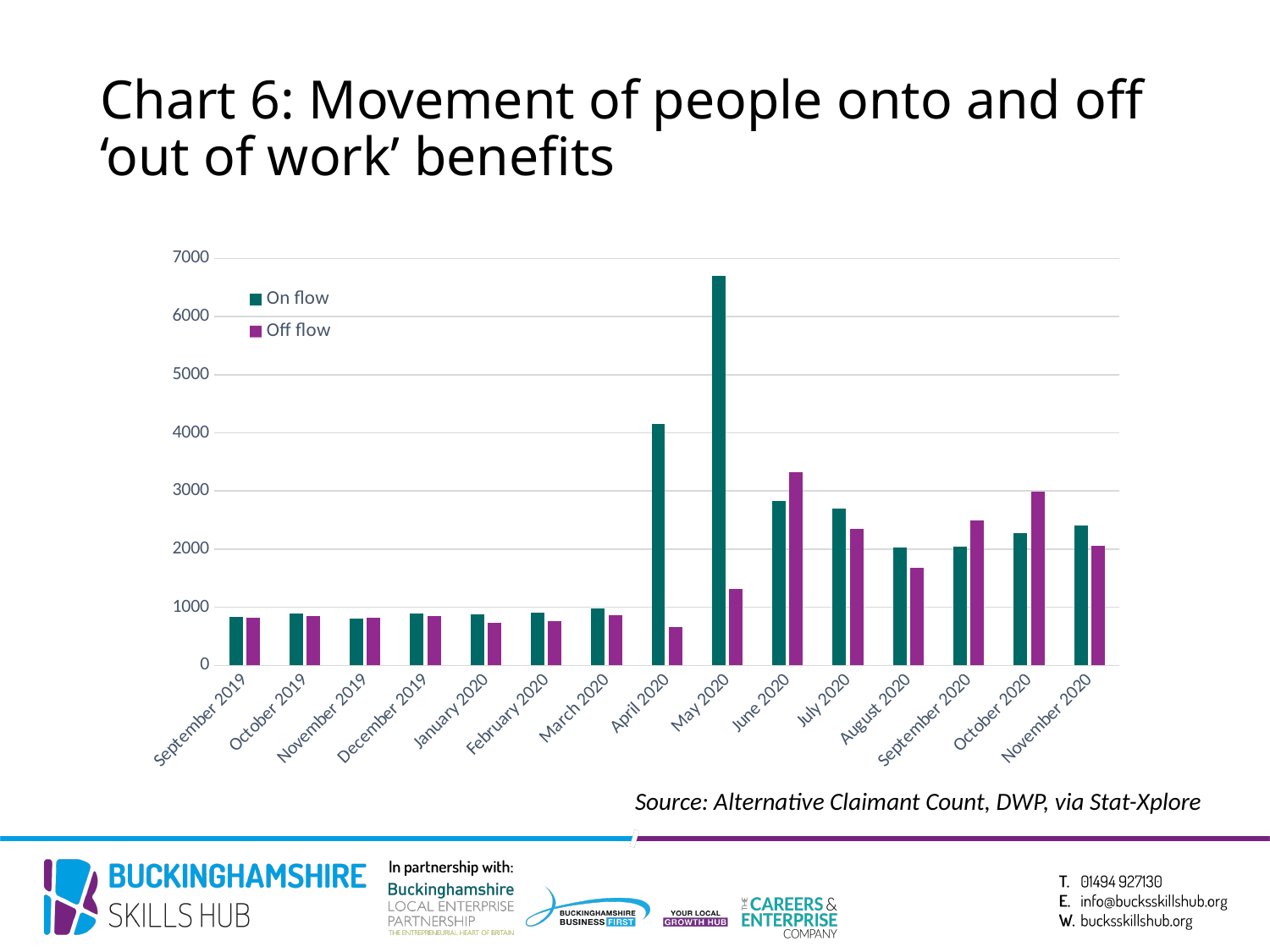
What is the source cited below the chart? Alternative Claimant Count, DWP, via Stat-Xplore In which month is the Off flow value lowest? April 2020 In which month is the On flow value highest? May 2020 How many months are shown on the x axis? 15 In June 2020, which is larger, On flow or Off flow? Off flow Does the On flow value rise or fall from May 2020 to August 2020? Fall How many series does the legend list? 2 What kind of chart is shown on the slide? Bar chart In which month is the Off flow value highest? June 2020 Is the On flow value for May 2020 greater or less than 6000? greater Is the On flow value for April 2020 greater or less than 4000? greater Is the Off flow value for April 2020 greater or less than 1000? less